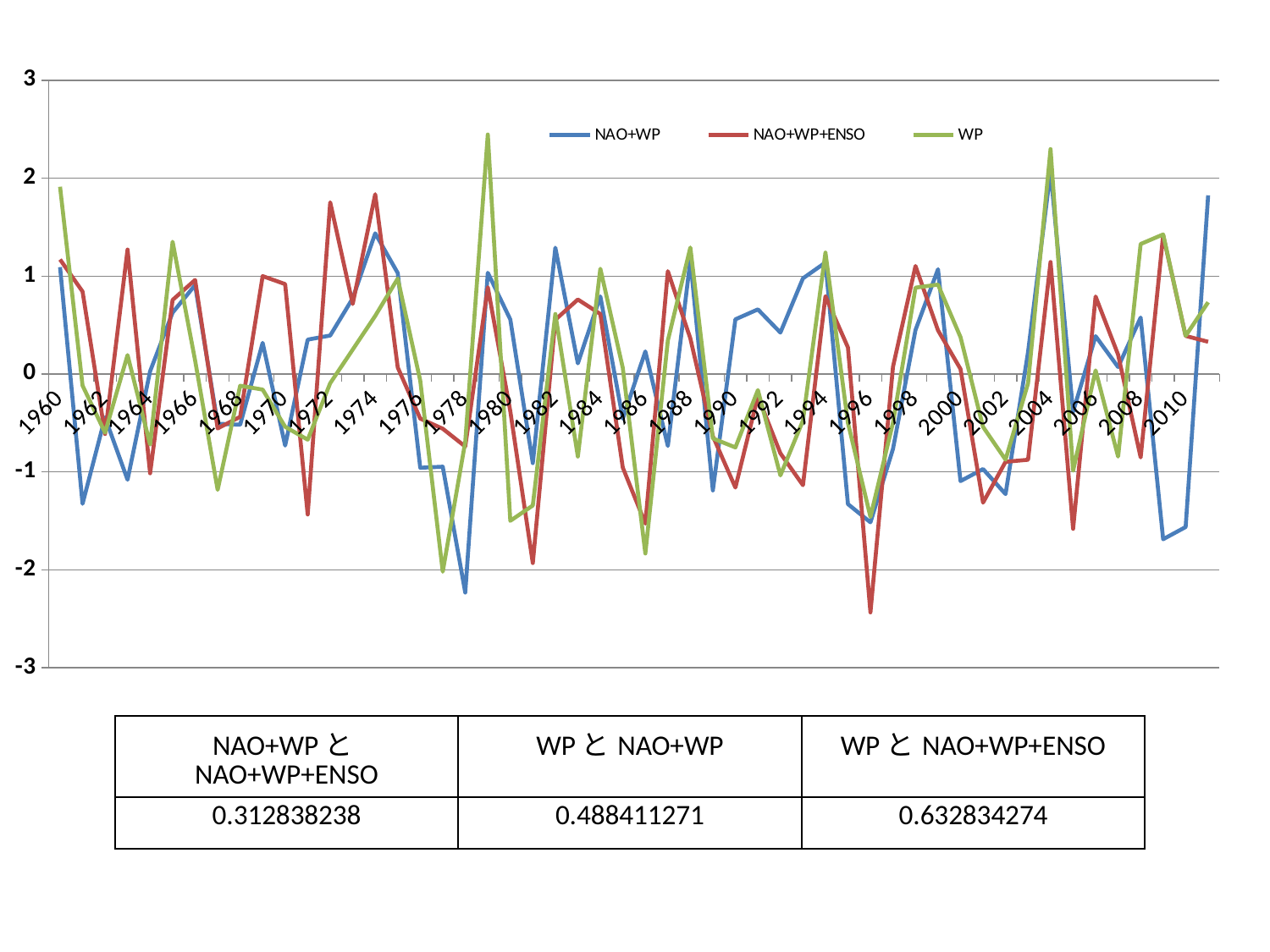
What is the first year labelled on the x axis of the chart? 1960 Is the value of the WP series in 1979 greater or less than 2? greater Which colour is used for the WP series in the chart? green Is the value of the WP series in 2004 greater or less than 2? greater What are the three series named in the chart's legend? NAO+WP, NAO+WP+ENSO, WP Is the value of the NAO+WP+ENSO series in 1972 greater or less than 1? greater Which series reaches the highest value anywhere on the chart? WP What kind of chart is shown on the slide? line chart How many series does the chart's legend list? 3